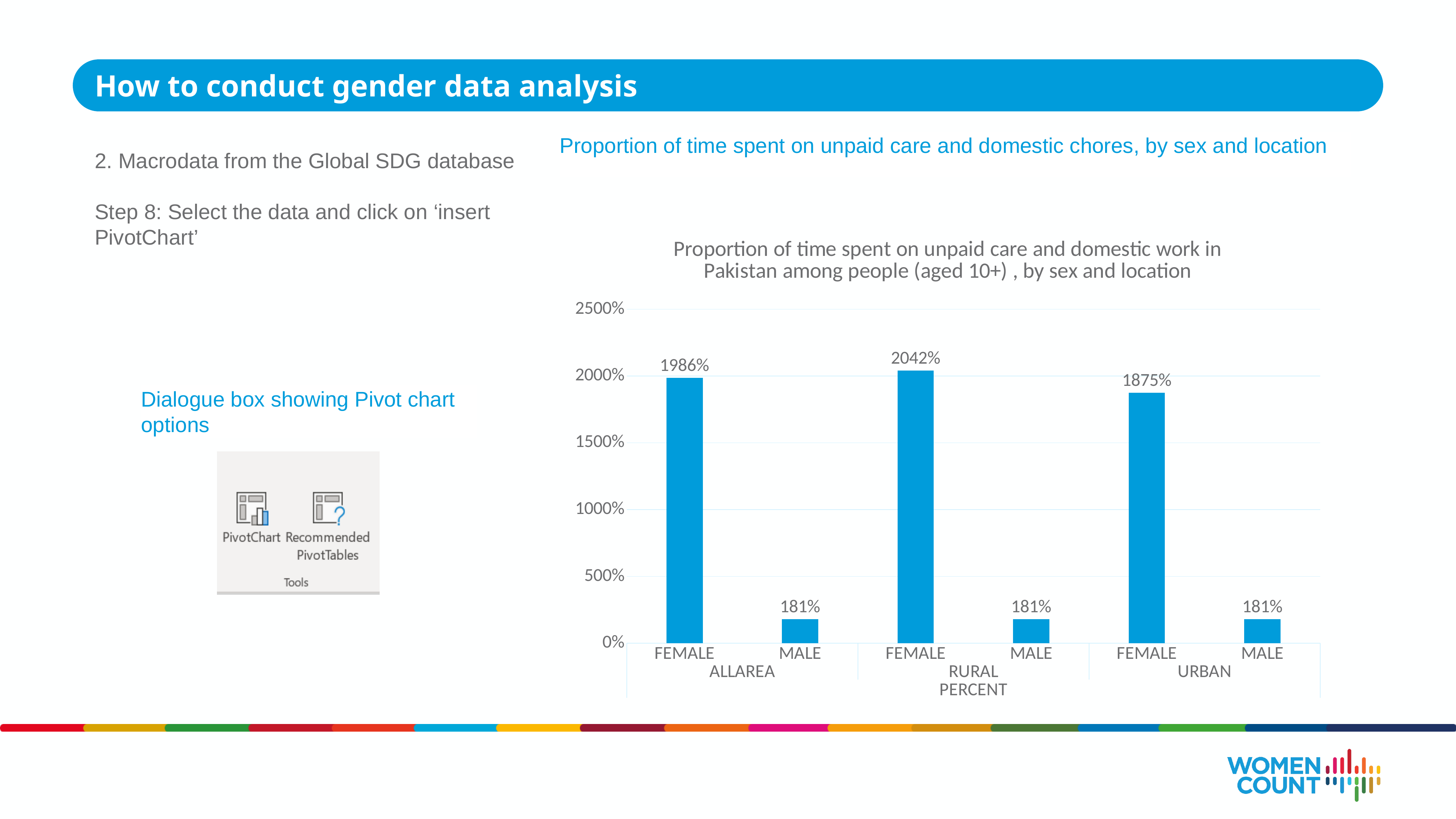
Which is larger, the FEMALE value for ALLAREA or the FEMALE value for URBAN? ALLAREA How many bars are plotted in the chart? 6 What is the value for FEMALE in the RURAL group? 2042% What is the value for FEMALE in the URBAN group? 1875% What is the difference between the FEMALE and MALE values in the ALLAREA group? 1805% What is the highest value shown on the vertical axis? 2500% Which bar has the highest value? FEMALE in RURAL What kind of chart is shown on the slide? Bar chart What is the value for MALE in the URBAN group? 181% What is the difference between the FEMALE values for RURAL and URBAN? 167% Which of the three FEMALE bars has the lowest value? URBAN What is the value for FEMALE in the ALLAREA group? 1986%